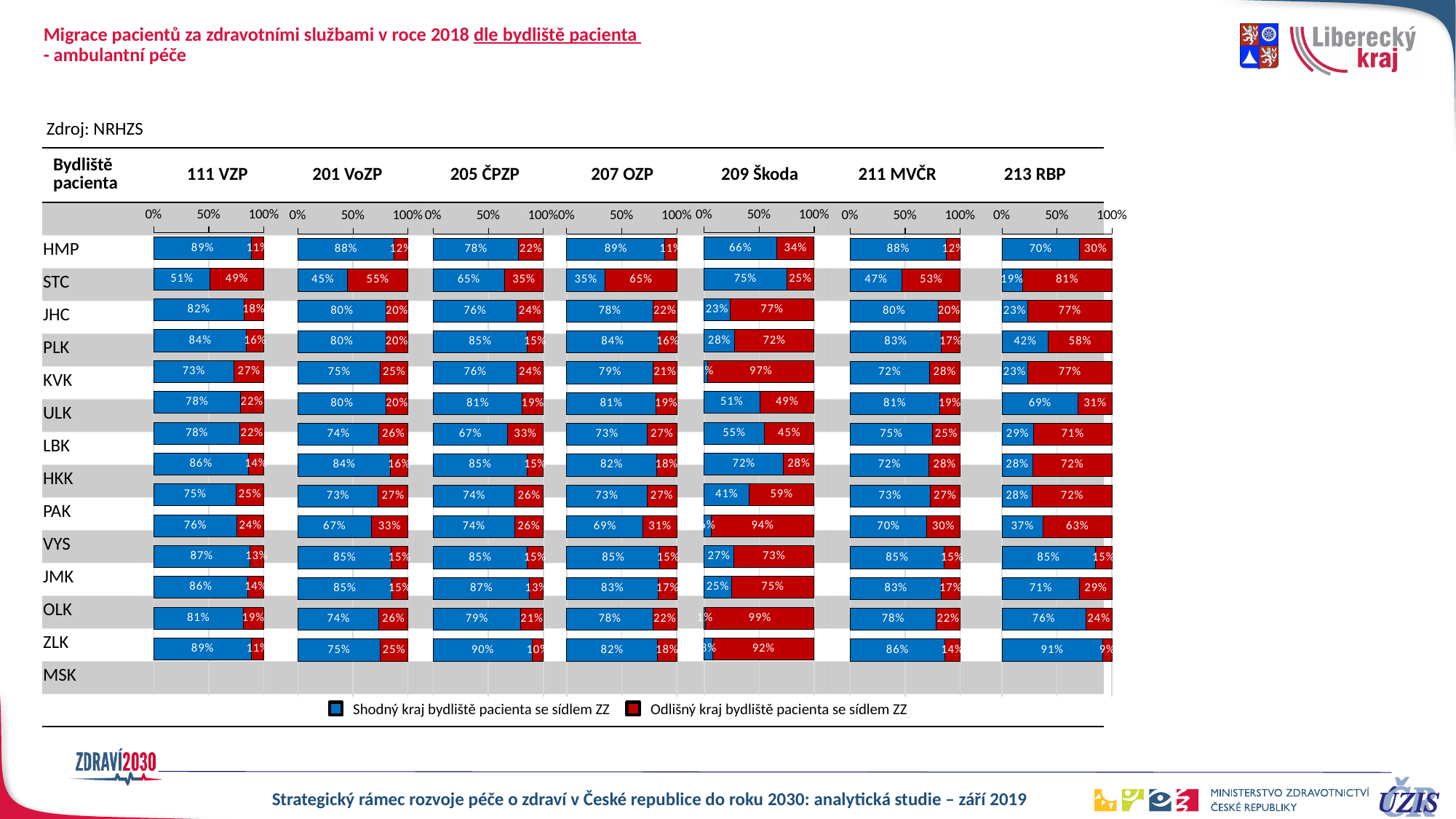
In the 205 ČPZP chart, is the blue share for JHC larger or smaller than the red share? larger For the STC row, which insurer chart shows the highest red share? 213 RBP In the 213 RBP chart, what is the blue share for STC? 19% For the HMP row, which insurer chart shows the lowest blue share? 209 Škoda What kind of chart is used for each insurer on the slide? bar chart How many insurer charts (columns) are shown on the slide? 7 How many series does the legend list? 2 In the 111 VZP chart, what is the blue (same region) share for HMP? 89% In the 207 OZP chart, what is the red share for STC? 65% In the 111 VZP chart, what is the difference between the blue and red shares for HMP? 78 percentage points What does the blue series represent according to the legend? Shodný kraj bydliště pacienta se sídlem ZZ In the 209 Škoda chart, what is the red (different region) share for HMP? 34%